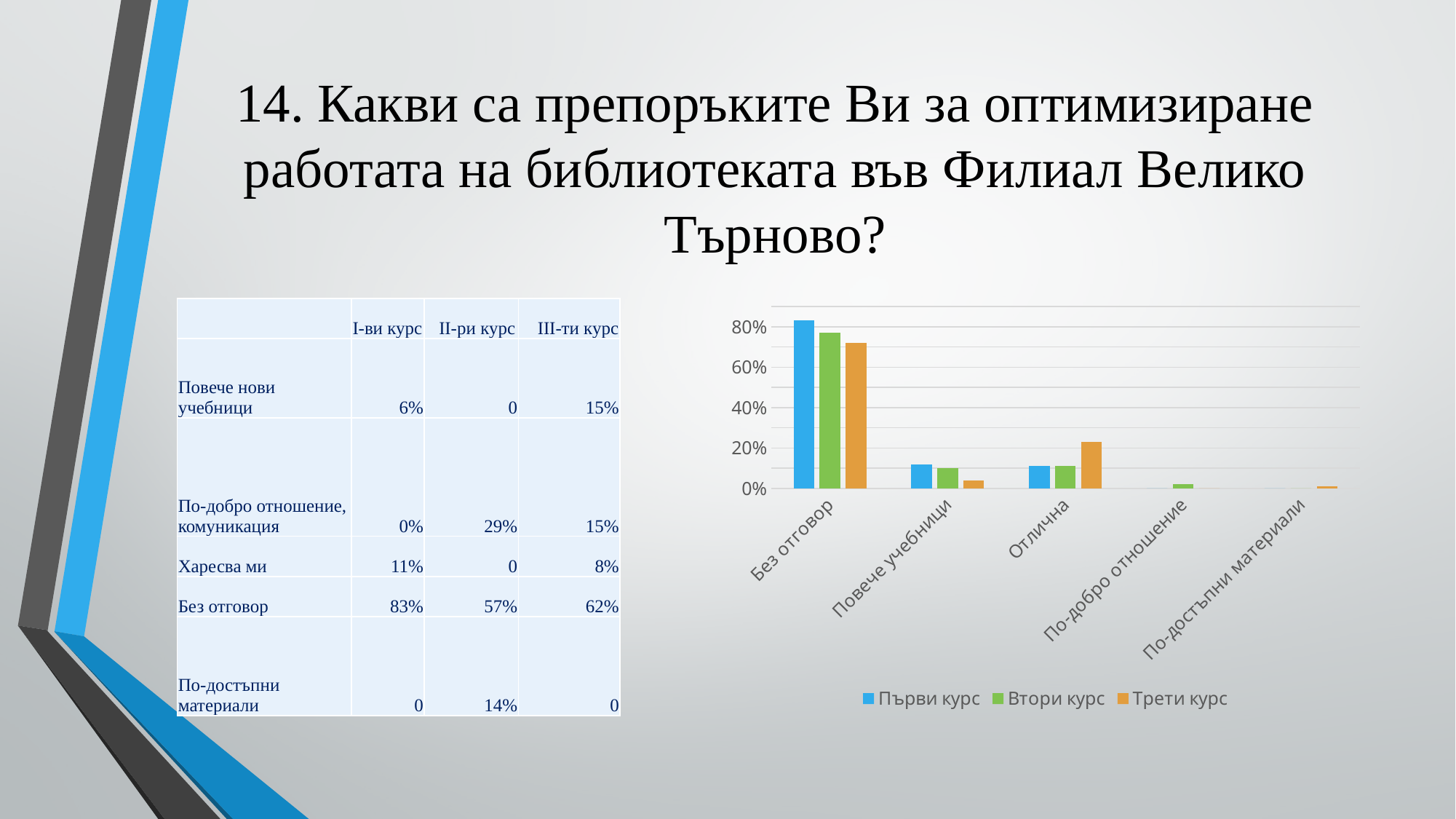
Is the value for Първи курс in the Без отговор category greater or less than 60%? greater In the Без отговор category, which is larger: the bar for Първи курс or the bar for Трети курс? Първи курс Which category has the highest bar for Първи курс in the chart? Без отговор What kind of chart is shown on the slide? bar chart In the Отлична category, which is larger: the bar for Първи курс or the bar for Трети курс? Трети курс Is the value for Втори курс in the Без отговор category greater or less than 60%? greater Is the value for Първи курс in the Повече учебници category greater or less than 20%? less What are the three entries in the chart legend? Първи курс, Втори курс, Трети курс How many categories are shown on the x axis of the chart? 5 What colour are the bars for Трети курс in the chart? orange How many series does the chart legend list? 3